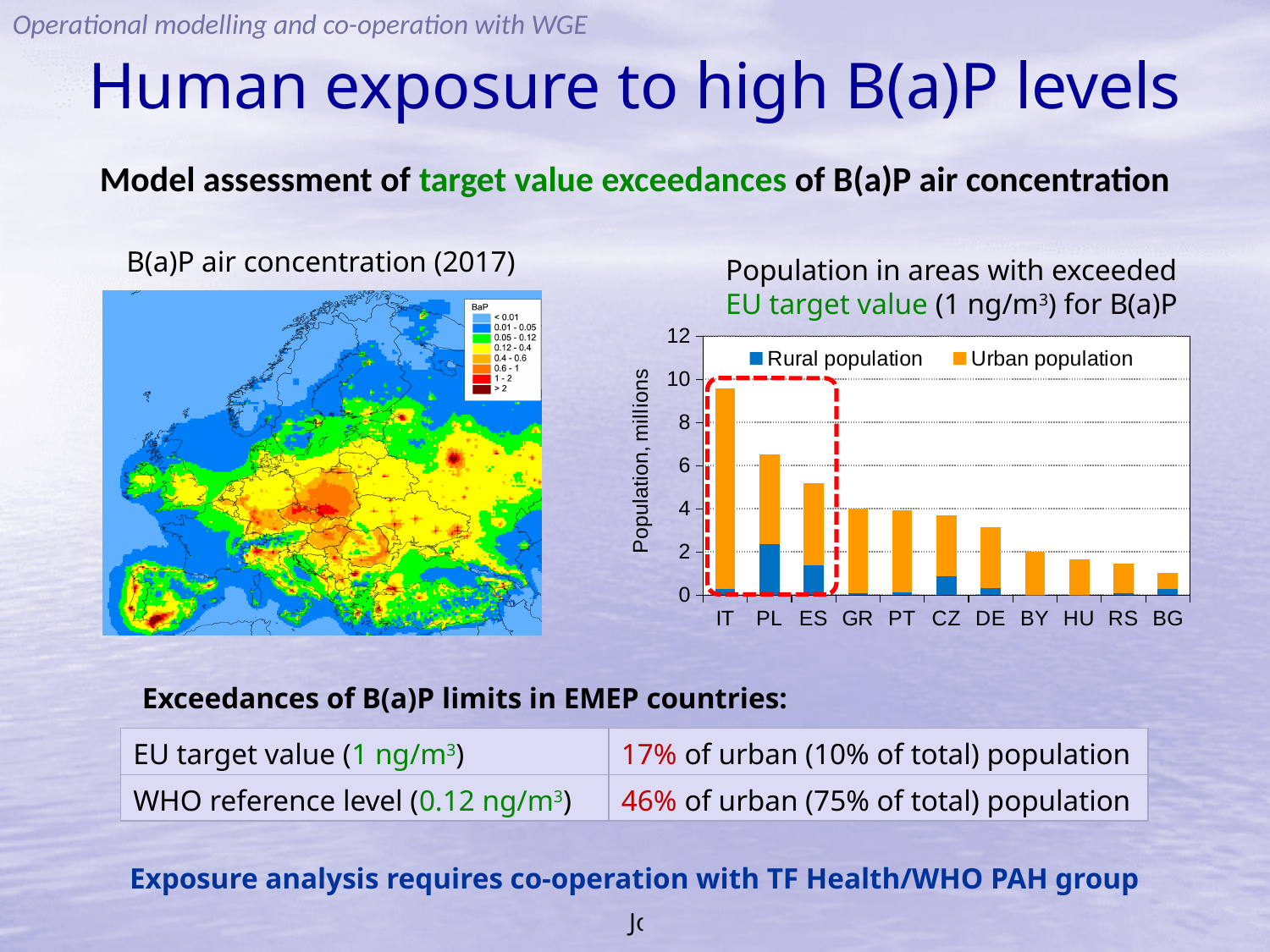
How many countries are shown on the x axis of the bar chart? 11 In the bar chart, is the total population for IT greater or less than 8 million? greater Which country has the lowest total population in areas with exceeded EU target value in the bar chart? BG Do the total bar heights in the bar chart rise or fall from left to right along the x axis? fall How many series does the legend of the bar chart list? 2 Which country has the highest total population in areas with exceeded EU target value in the bar chart? IT In the bar chart, which has a larger total population, PL or ES? PL Which colour represents Urban population in the bar chart? orange What kind of chart is shown on the right of the slide? bar chart In the bar chart, is the total population for HU greater or less than 2 million? less In the bar chart, is the total population for PL greater or less than 6 million? greater